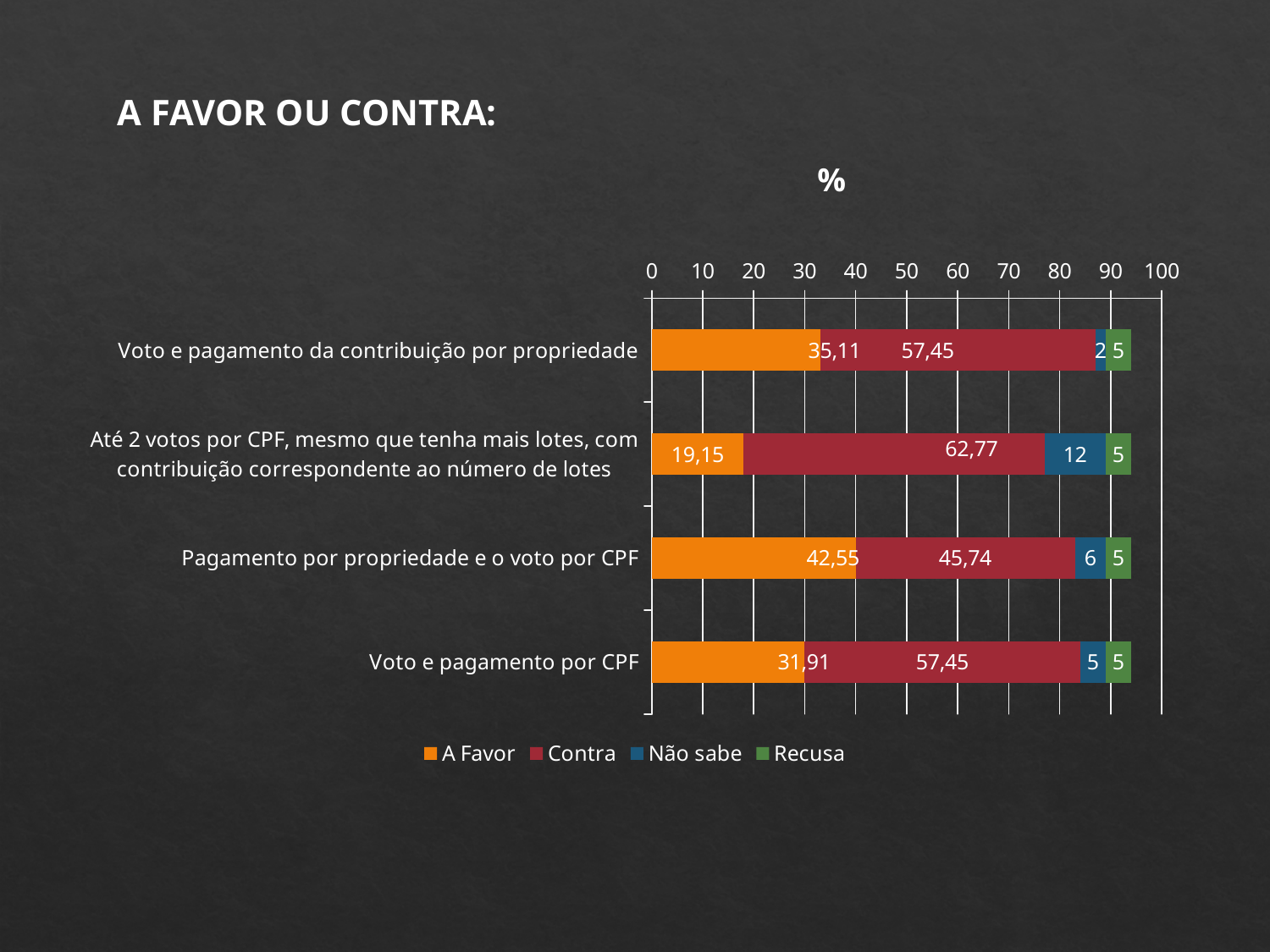
What is the total of the stacked bar for 'Voto e pagamento por CPF'? 99,36 How many categories are plotted in the chart? 4 What is the 'A Favor' value for 'Voto e pagamento da contribuição por propriedade'? 35,11 What is the difference between the 'Contra' and 'A Favor' values for 'Pagamento por propriedade e o voto por CPF'? 3,19 What is the 'Não sabe' value for 'Pagamento por propriedade e o voto por CPF'? 6 What type of chart is shown on the slide? Stacked bar chart Which is larger for 'Voto e pagamento por CPF': the 'A Favor' value or the 'Contra' value? Contra What is the 'Contra' value for 'Até 2 votos por CPF, mesmo que tenha mais lotes, com contribuição correspondente ao número de lotes'? 62,77 Which category has the highest 'A Favor' value? Pagamento por propriedade e o voto por CPF Which category has the lowest 'A Favor' value? Até 2 votos por CPF, mesmo que tenha mais lotes, com contribuição correspondente ao número de lotes How many series does the legend list? 4 What is the title of the chart? %